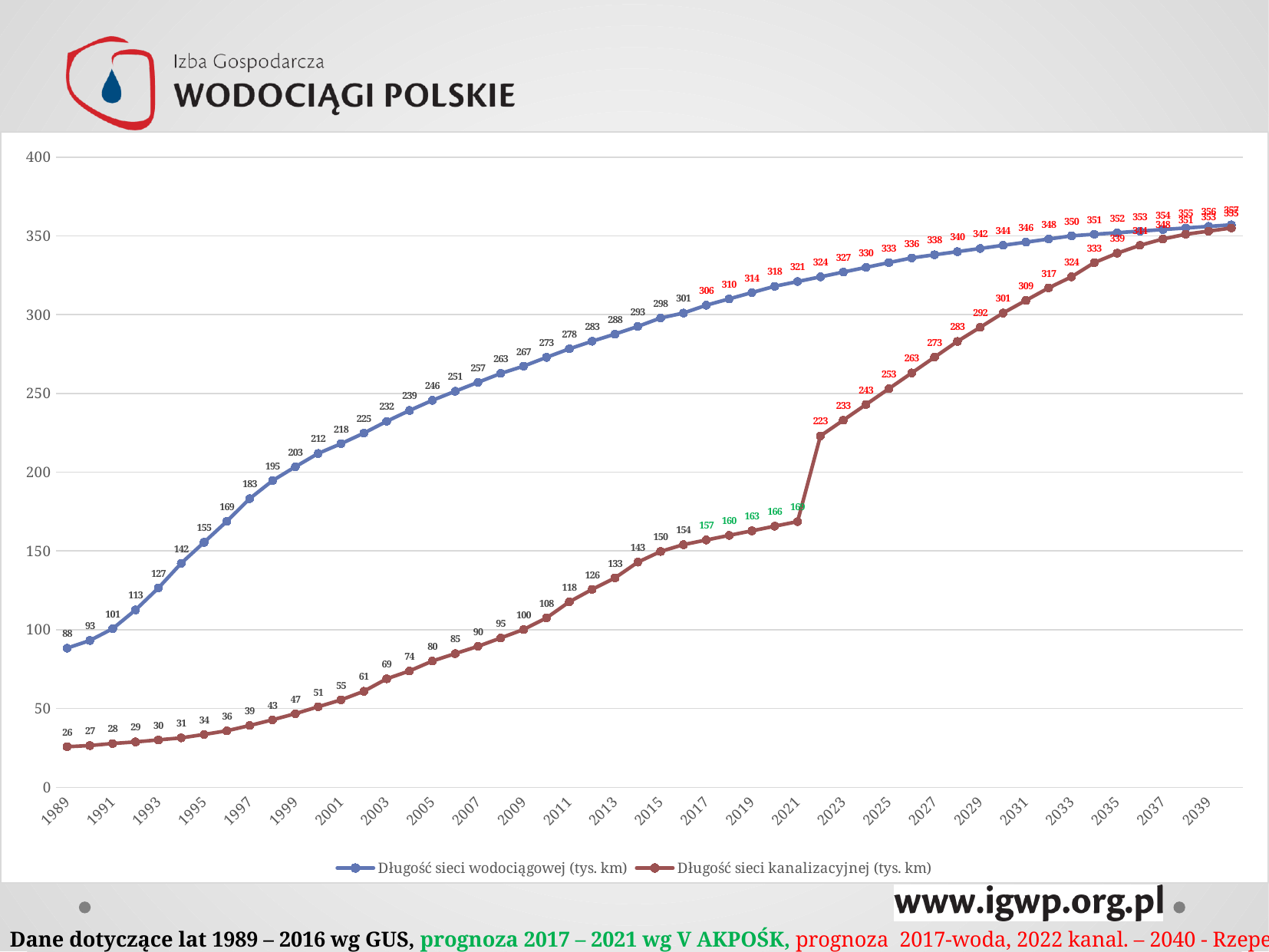
What is the value of Długość sieci kanalizacyjnej (tys. km) in 1989? 26 What is the value of Długość sieci kanalizacyjnej (tys. km) in 2015? 150 In 2001, which series has the larger value, Długość sieci wodociągowej or Długość sieci kanalizacyjnej? Długość sieci wodociągowej (tys. km) What is the value of Długość sieci wodociągowej (tys. km) in 2009? 267 What is the value of Długość sieci kanalizacyjnej (tys. km) in 2025? 253 What is the difference between Długość sieci wodociągowej and Długość sieci kanalizacyjnej in 1989? 62 What kind of chart is shown on the slide? line chart In which year is Długość sieci wodociągowej (tys. km) lowest? 1989 What is the value of Długość sieci wodociągowej (tys. km) in 1989? 88 What is the difference between Długość sieci wodociągowej and Długość sieci kanalizacyjnej in 2015? 148 How many series does the legend list? 2 Do the values of Długość sieci kanalizacyjnej (tys. km) rise or fall from 1989 to 2039? rise